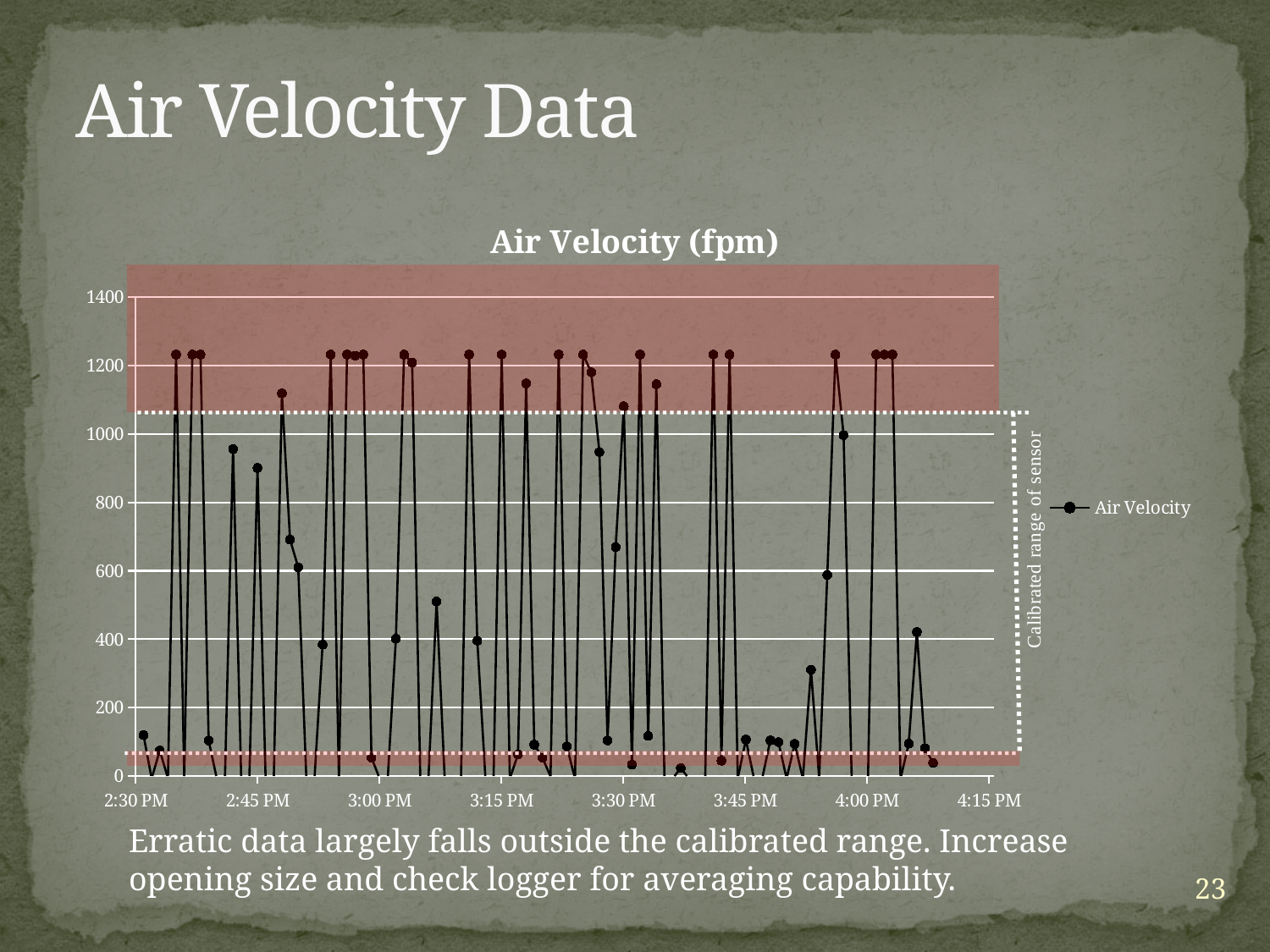
What is the title of the chart? Air Velocity (fpm) What is the name of the series shown in the legend? Air Velocity Do the plotted values show a steady rising or falling trend along the x axis, or do they fluctuate erratically? Fluctuate erratically Is the highest plotted air velocity value greater or less than 1000? greater How many time labels are shown on the x axis? 8 What kind of chart is shown on the slide? Line chart How many series does the legend list? 1 Is the highest plotted value greater or less than 1400? less Is the lowest plotted air velocity value greater or less than 200? less